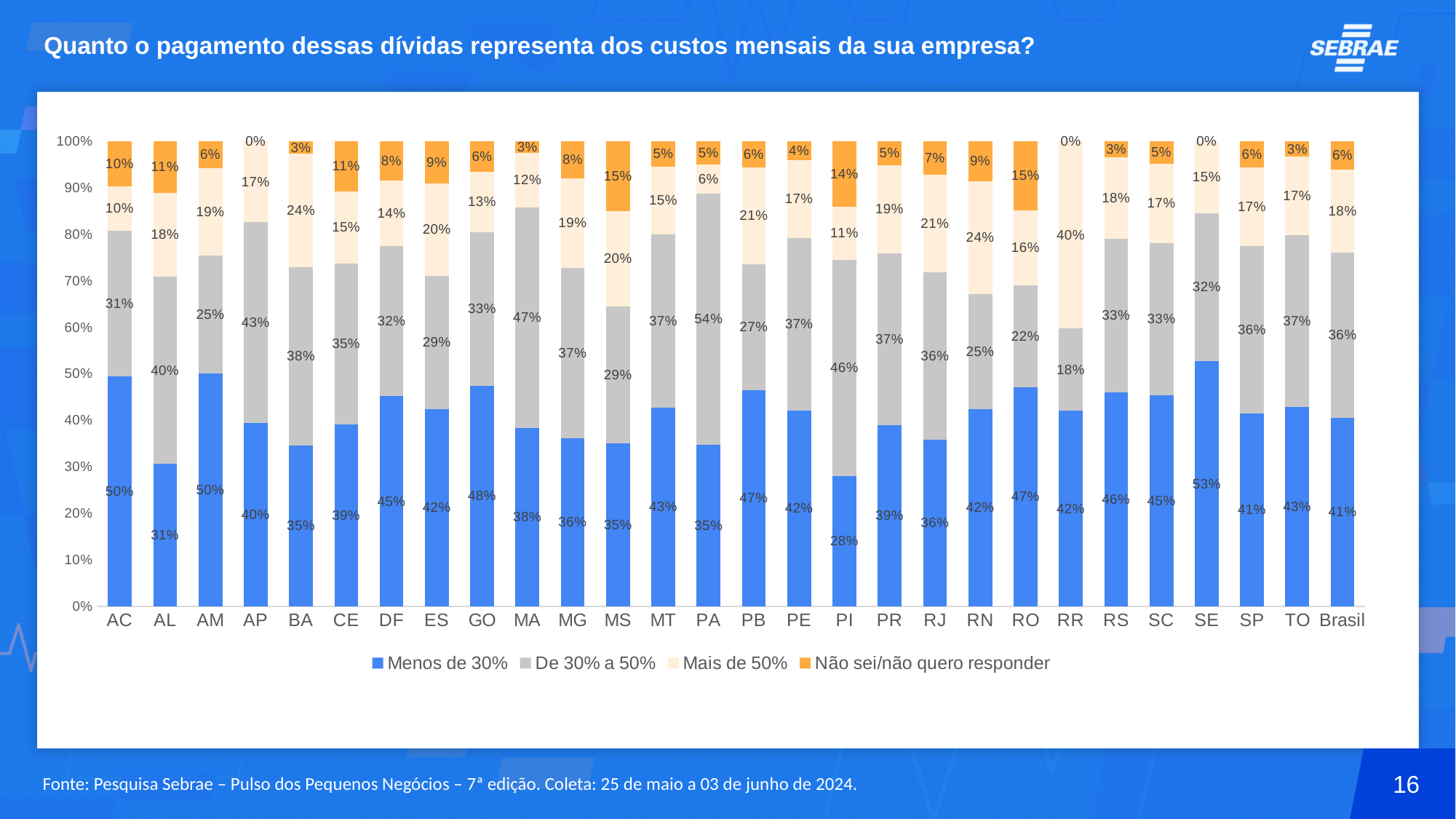
Which is larger, the 'De 30% a 50%' value for MA or for MG? MA What is the value of 'Mais de 50%' for RR? 40% Which category has the lowest value for 'Menos de 30%'? PI What is the value of 'Não sei/não quero responder' for PI? 14% Which series is shown in orange in the legend? Não sei/não quero responder How many categories are shown on the x axis? 28 Which category has the highest value for 'De 30% a 50%'? PA What is the value of 'Menos de 30%' for Brasil? 41% How many series does the legend list? 4 Which category has the highest value for 'Menos de 30%'? SE What is the difference between the 'Menos de 30%' values for SE and AL? 22% What type of chart is shown on the slide? Stacked bar chart